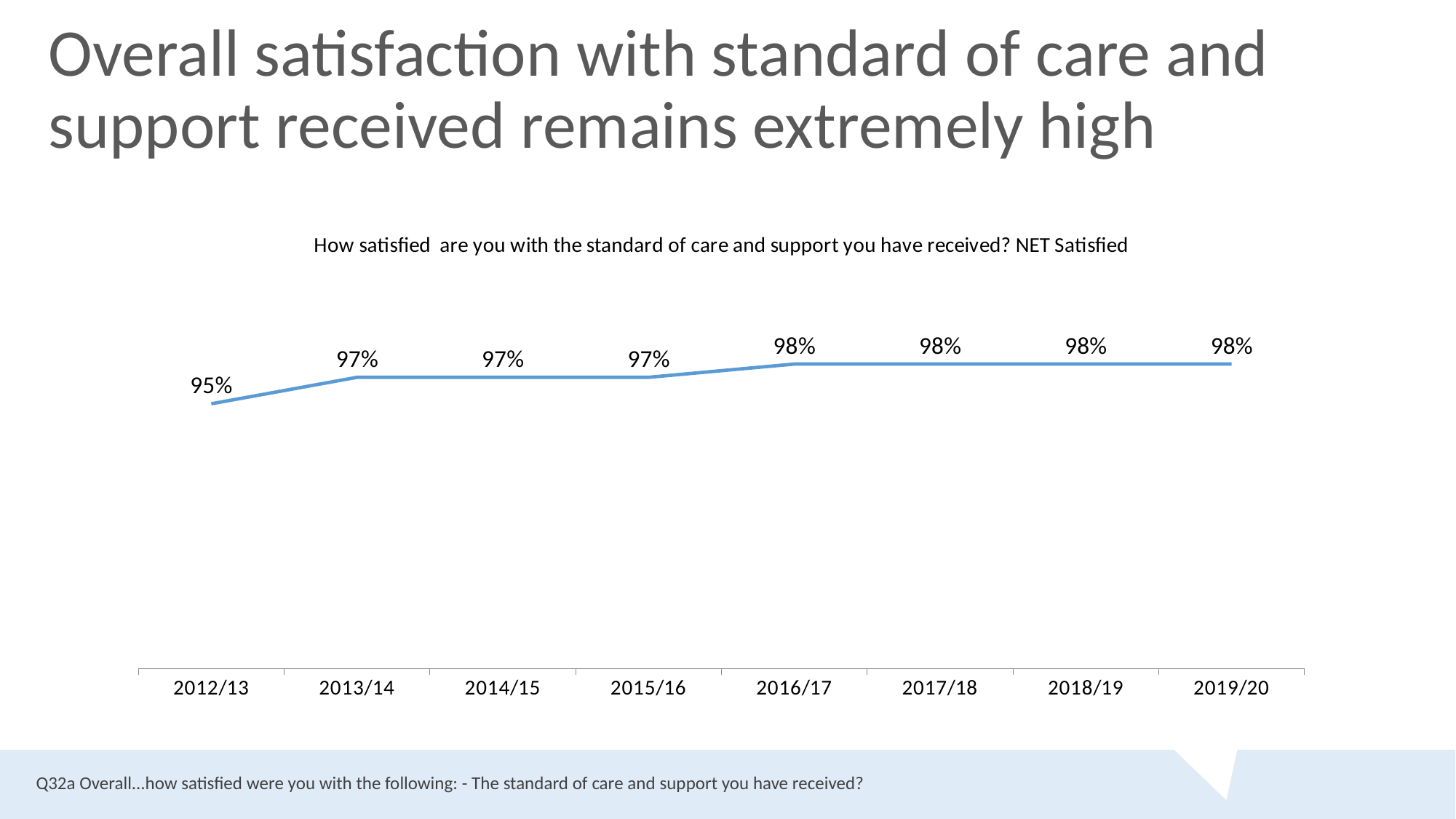
What is the NET Satisfied value for 2012/13? 95% What is the title of the chart? How satisfied are you with the standard of care and support you have received? NET Satisfied Which year has the lowest NET Satisfied value? 2012/13 How many years are plotted on the chart? 8 What kind of chart is shown on the slide? Line chart What is the difference between the NET Satisfied values for 2019/20 and 2012/13? 3% What is the difference between the NET Satisfied values for 2013/14 and 2012/13? 2% What is the NET Satisfied value for 2016/17? 98% Which is larger, the NET Satisfied value for 2012/13 or for 2014/15? 2014/15 Do the NET Satisfied values rise or fall from 2012/13 to 2019/20? Rise What is the NET Satisfied value for 2015/16? 97% What is the NET Satisfied value for 2019/20? 98%